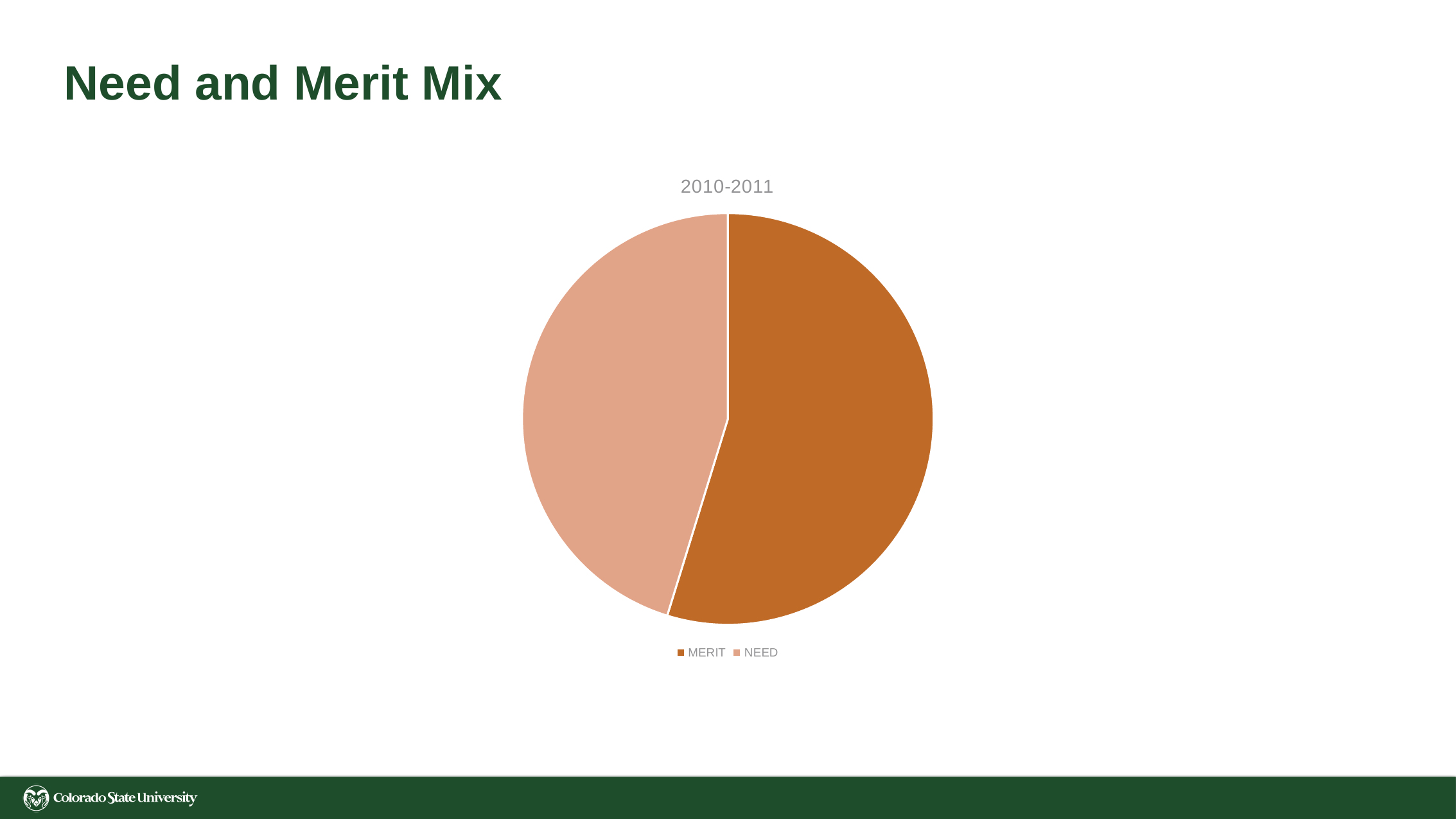
What colour is the NEED slice in the pie chart? light orange Which category has the smallest slice in the pie chart? NEED What kind of chart is shown on the slide? pie chart How many slices does the pie chart have? 2 Which category has the largest slice in the pie chart? MERIT What is the title of the slide? Need and Merit Mix How many entries does the legend of the pie chart list? 2 What is the title of the pie chart? 2010-2011 Which slice is larger, MERIT or NEED? MERIT